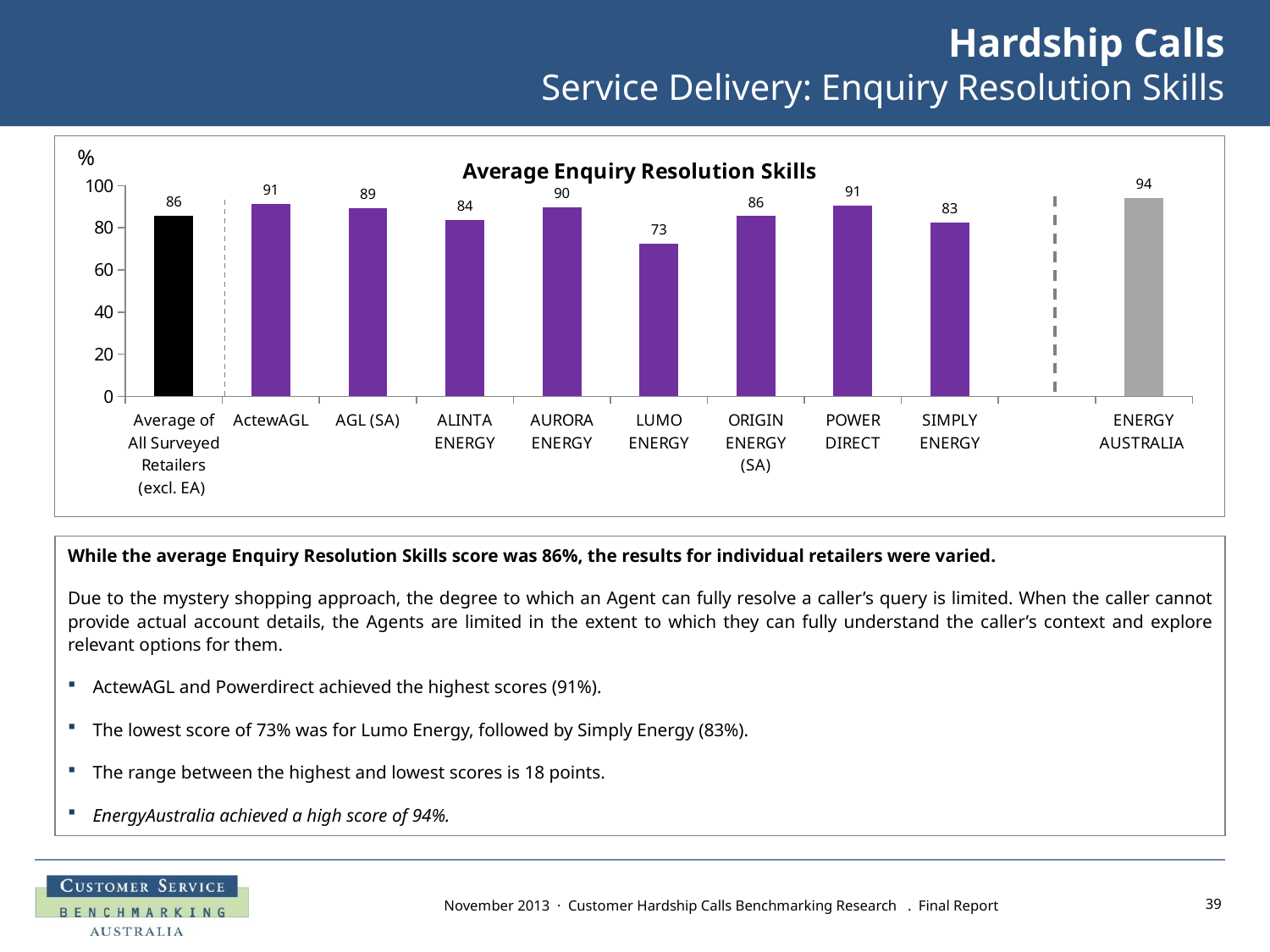
What is the value for SIMPLY ENERGY? 83 Which is larger, the value for AGL (SA) or the value for ALINTA ENERGY? AGL (SA) What is the value for the Average of All Surveyed Retailers (excl. EA)? 86 What is the difference between the values for ActewAGL and LUMO ENERGY? 18 What is the value for ENERGY AUSTRALIA? 94 What is the value for LUMO ENERGY? 73 How many bars are shown in the chart? 10 What is the title of the chart? Average Enquiry Resolution Skills What kind of chart is shown? bar chart Which category has the lowest value? LUMO ENERGY Which category has the highest value? ENERGY AUSTRALIA Is the value for LUMO ENERGY greater or less than 80? less